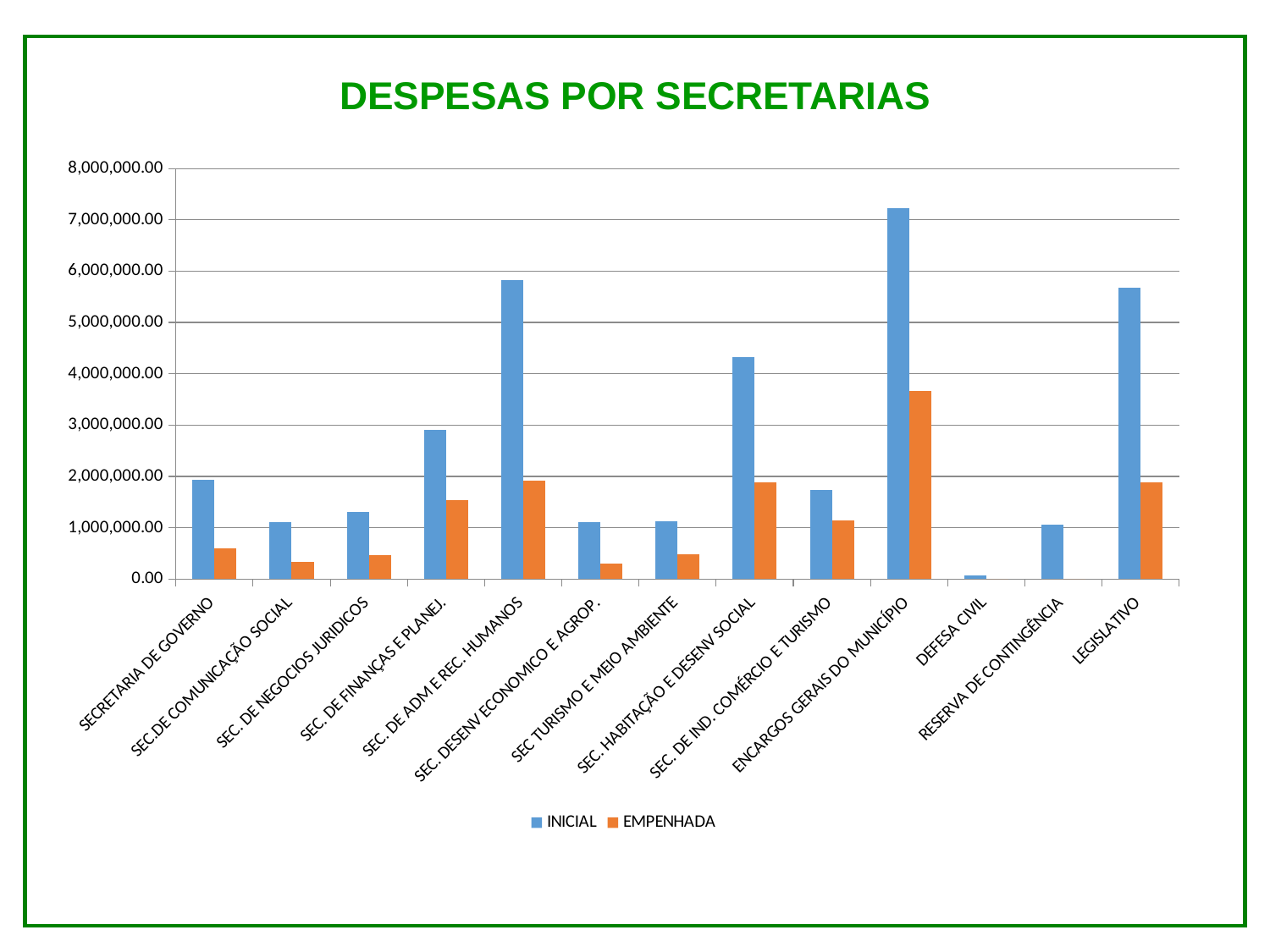
What is the title of the chart? DESPESAS POR SECRETARIAS Is the INICIAL value for SEC. DE ADM E REC. HUMANOS greater or less than 5,000,000.00? greater Which is larger: the INICIAL value for SEC. HABITAÇÃO E DESENV SOCIAL or the INICIAL value for SEC. DE FINANÇAS E PLANEJ.? SEC. HABITAÇÃO E DESENV SOCIAL Is the EMPENHADA value for ENCARGOS GERAIS DO MUNICÍPIO greater or less than 3,000,000.00? greater How many categories (secretarias) are shown on the x axis? 13 How many series does the legend list? 2 Which colour represents the EMPENHADA series? orange Which category has the lowest INICIAL value? DEFESA CIVIL What type of chart is shown on the slide? bar chart Which category has the highest EMPENHADA value? ENCARGOS GERAIS DO MUNICÍPIO Which category has the highest INICIAL value? ENCARGOS GERAIS DO MUNICÍPIO